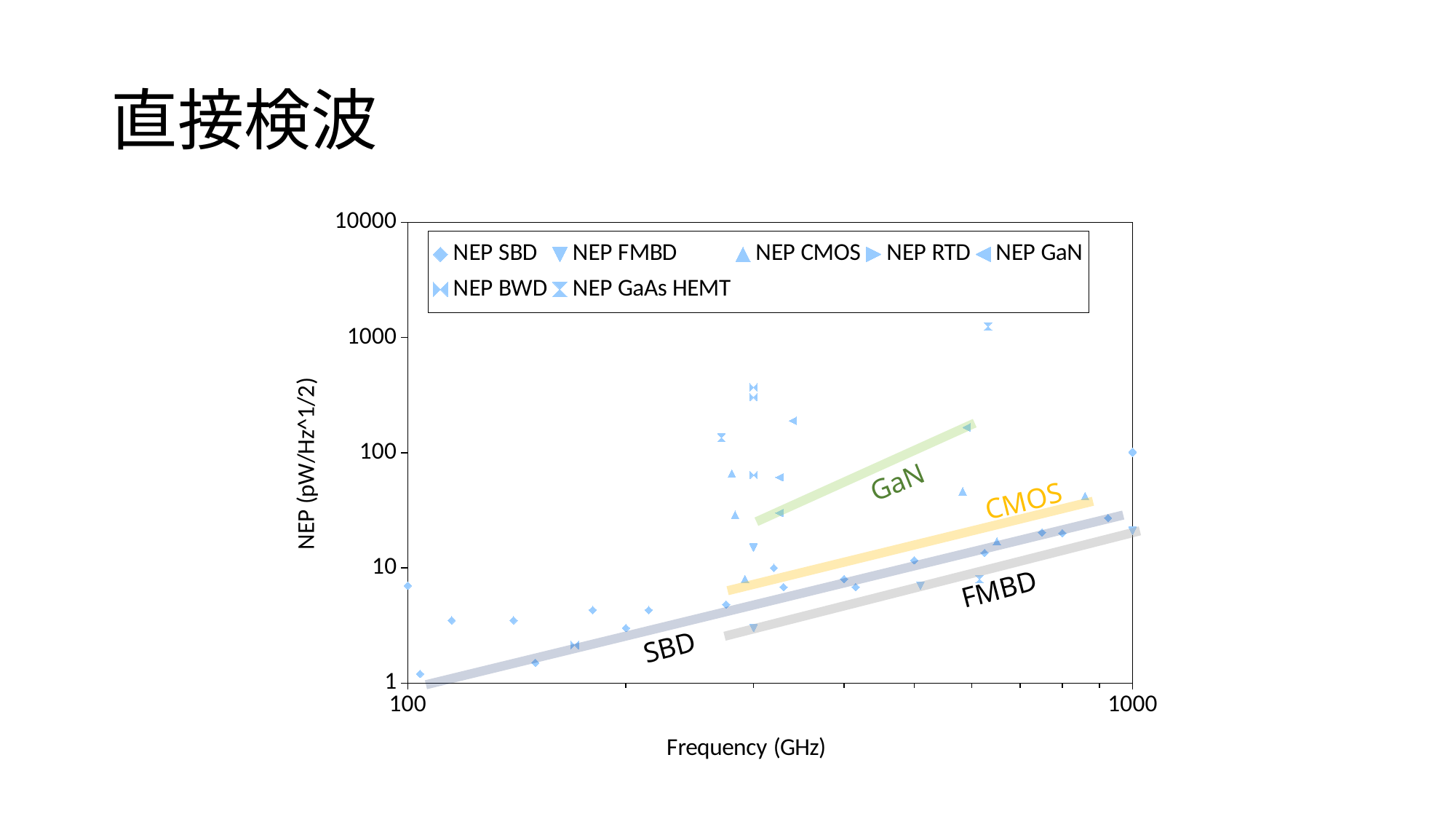
What kind of chart is shown on the slide? scatter chart Is the value of the NEP GaAs HEMT point near 1000 GHz greater or less than 1000? greater Is the value of the NEP CMOS point near 600 GHz greater or less than 100? less How many series does the legend list? 7 Is the value of the NEP SBD point at 100 GHz greater or less than 10? less Which series has the highest plotted value on the chart? NEP GaAs HEMT Do the NEP SBD values generally rise or fall as frequency increases from 100 GHz to 1000 GHz? rise Which of the two points near 300 GHz is larger, the NEP BWD point or the NEP FMBD point? NEP BWD What is the label of the y axis? NEP (pW/Hz^1/2) What is the label of the x axis? Frequency (GHz)